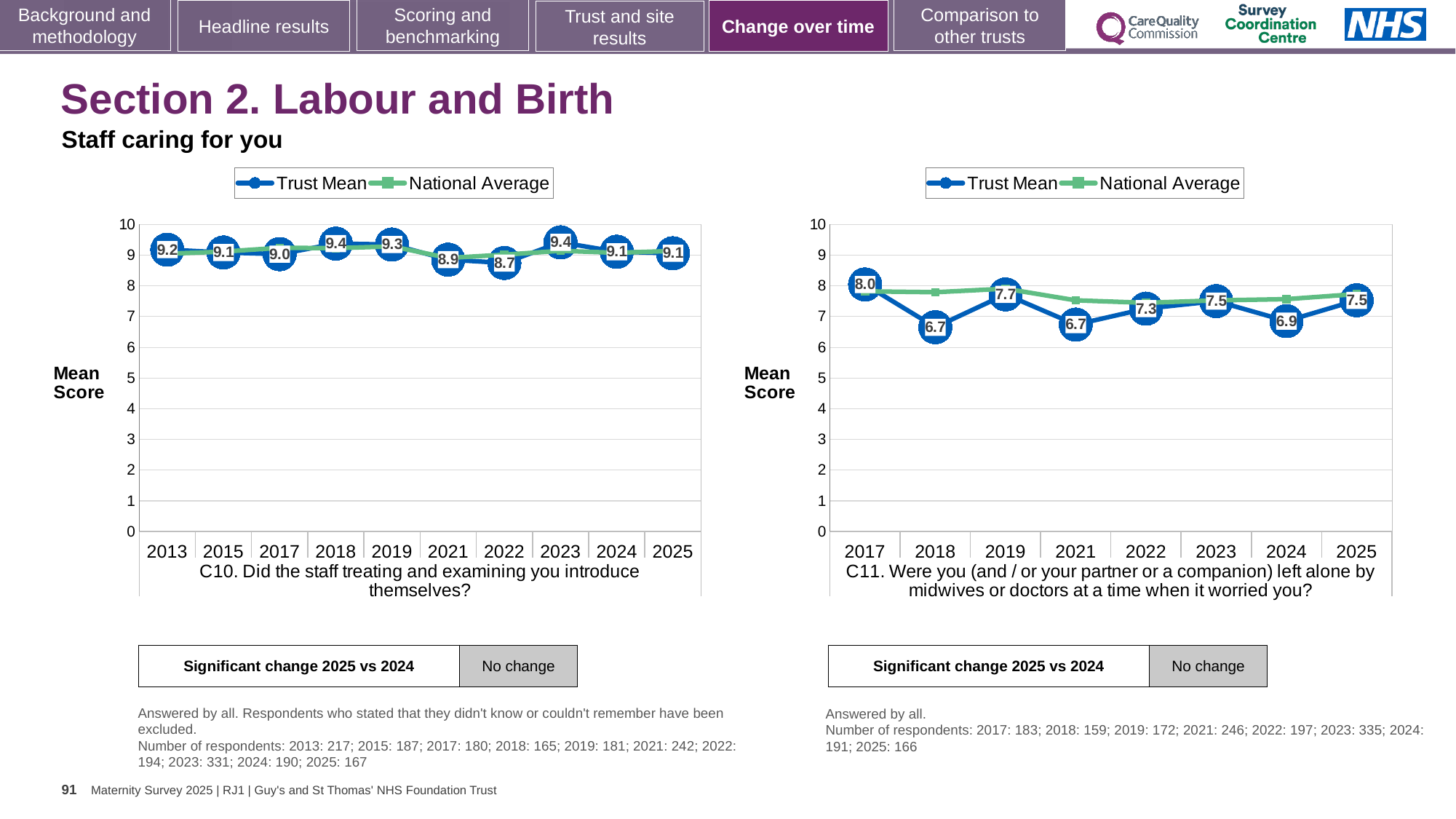
In the C11 chart (right), what is the Trust Mean score for 2024? 6.9 In the C11 chart (right), which year has the highest Trust Mean score? 2017 In the C11 chart (right), is the Trust Mean score for 2019 larger or smaller than the score for 2018? larger What type of chart is the C11 chart (right)? Line chart In the C11 chart (right), what is the difference between the Trust Mean scores for 2017 and 2018? 1.3 In the C10 chart (left), how many years are plotted on the x axis? 10 In the C11 chart (right), what is the Trust Mean score for 2017? 8.0 In the C10 chart (left), what is the Trust Mean score for 2013? 9.2 In the C11 chart (right), how many series does the legend list? 2 In the C10 chart (left), which year has the lowest Trust Mean score? 2022 In the C10 chart (left), what is the Trust Mean score for 2022? 8.7 In the C10 chart (left), what is the difference between the Trust Mean scores for 2018 and 2022? 0.7